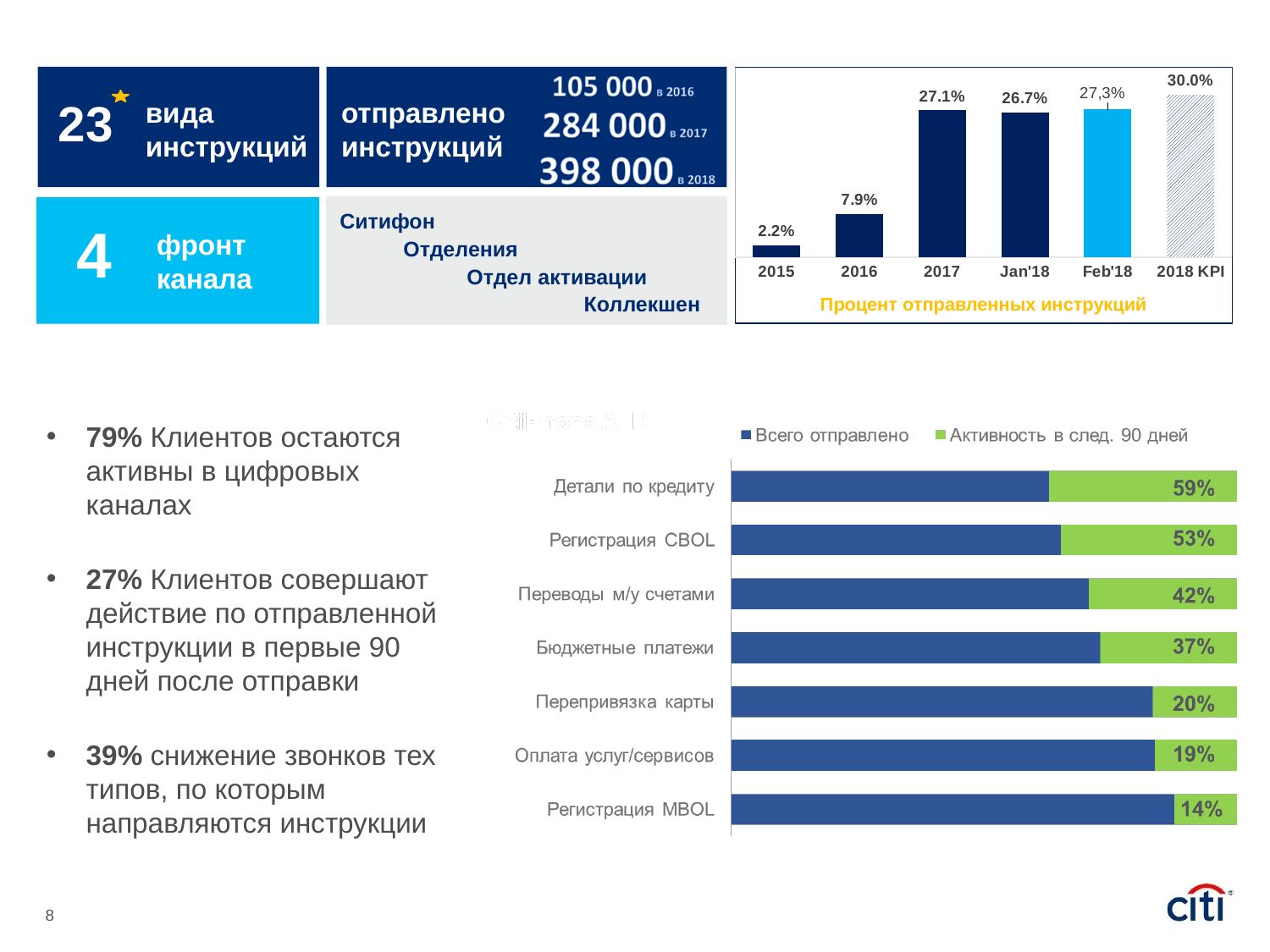
In the chart titled 'Процент отправленных инструкций', what is the value for Jan'18? 26.7% In the chart titled 'Процент отправленных инструкций', which category has the lowest value? 2015 In the chart titled 'Процент отправленных инструкций', how many categories are shown on the x axis? 6 In the bottom-right stacked bar chart, how many series does the legend list? 2 In the chart titled 'Процент отправленных инструкций', which is larger, the value for 2016 or the value for 2015? 2016 In the chart titled 'Процент отправленных инструкций', what is the difference between the values for 2017 and 2016? 19.2 percentage points In the chart titled 'Процент отправленных инструкций', what is the value for 2018 KPI? 30.0% In the bottom-right stacked bar chart, what is the green label value for 'Детали по кредиту'? 59% In the chart titled 'Процент отправленных инструкций', what is the value for 2016? 7.9% In the bottom-right stacked bar chart, how many categories are shown? 7 In the bottom-right stacked bar chart, which category has the lowest green label value? Регистрация MBOL In the bottom-right stacked bar chart, what is the green label value for 'Бюджетные платежи'? 37%